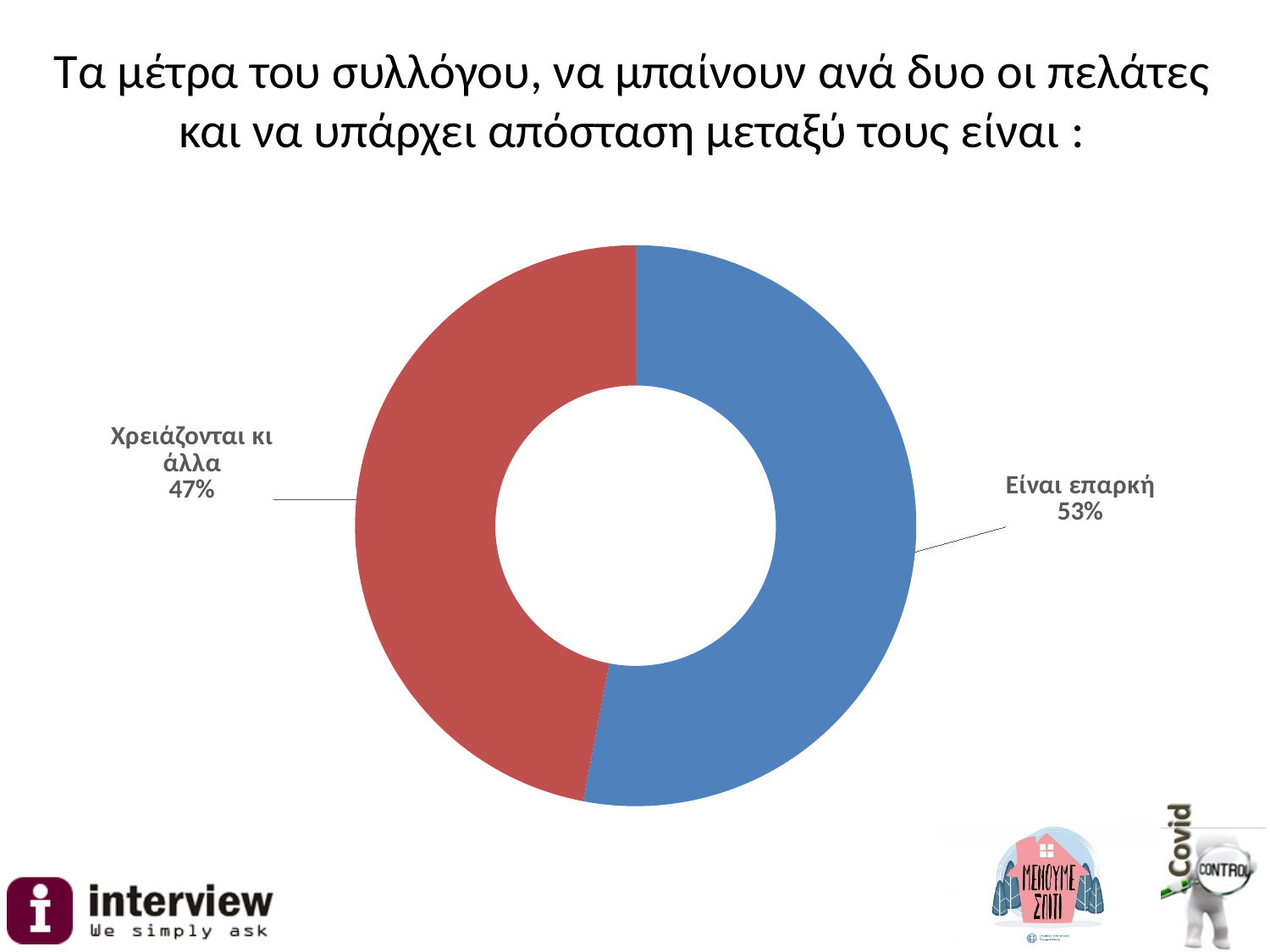
What percentage of respondents answered "Χρειάζονται κι άλλα"? 47% What percentage of respondents answered "Είναι επαρκή"? 53% What colour is the "Είναι επαρκή" slice? Blue Which is larger: the share for "Είναι επαρκή" or the share for "Χρειάζονται κι άλλα"? Είναι επαρκή What colour is the "Χρειάζονται κι άλλα" slice? Red What is the difference in percentage points between "Είναι επαρκή" and "Χρειάζονται κι άλλα"? 6 percentage points Which response has the larger share of the pie? Είναι επαρκή What share of the pie does the "Είναι επαρκή" slice represent? 53% How many categories are shown in the chart? 2 Which response has the smaller share of the pie? Χρειάζονται κι άλλα What kind of chart is shown on the slide? Pie chart (doughnut)